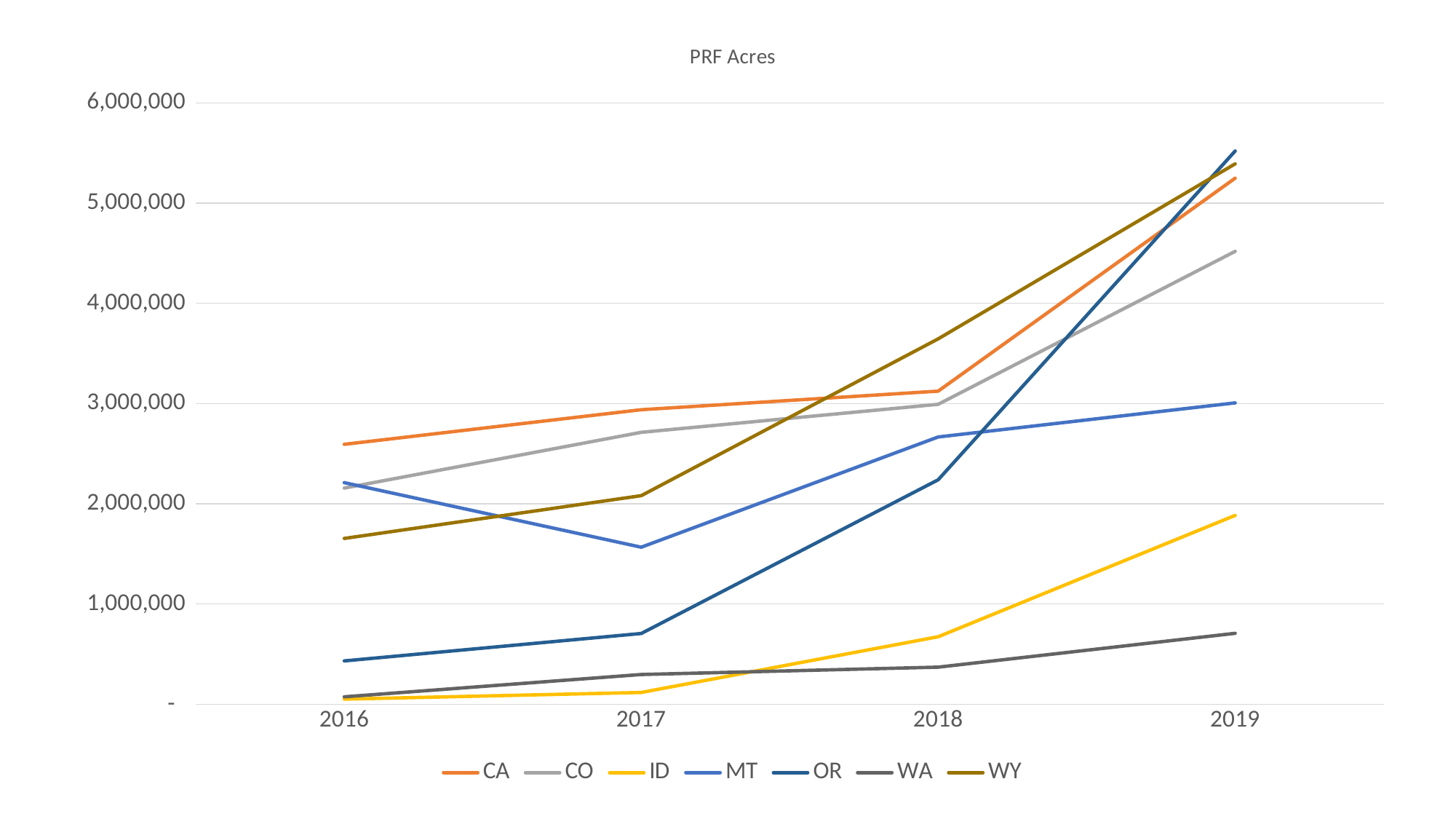
Is the value for WY in 2018 greater or less than 3,000,000? greater Does the value for MT rise or fall from 2016 to 2017? fall What is the title of the chart? PRF Acres How many series does the legend list? 7 Which series has the highest value in 2016? CA How many years are shown on the x axis? 4 What kind of chart is shown on the slide? line chart Which is larger in 2016, MT or WY? MT Which is larger in 2019, CA or CO? CA Is the value for ID in 2019 greater or less than 2,000,000? less Which series has the lowest value in 2019? WA Is the value for CA in 2016 greater or less than 3,000,000? less